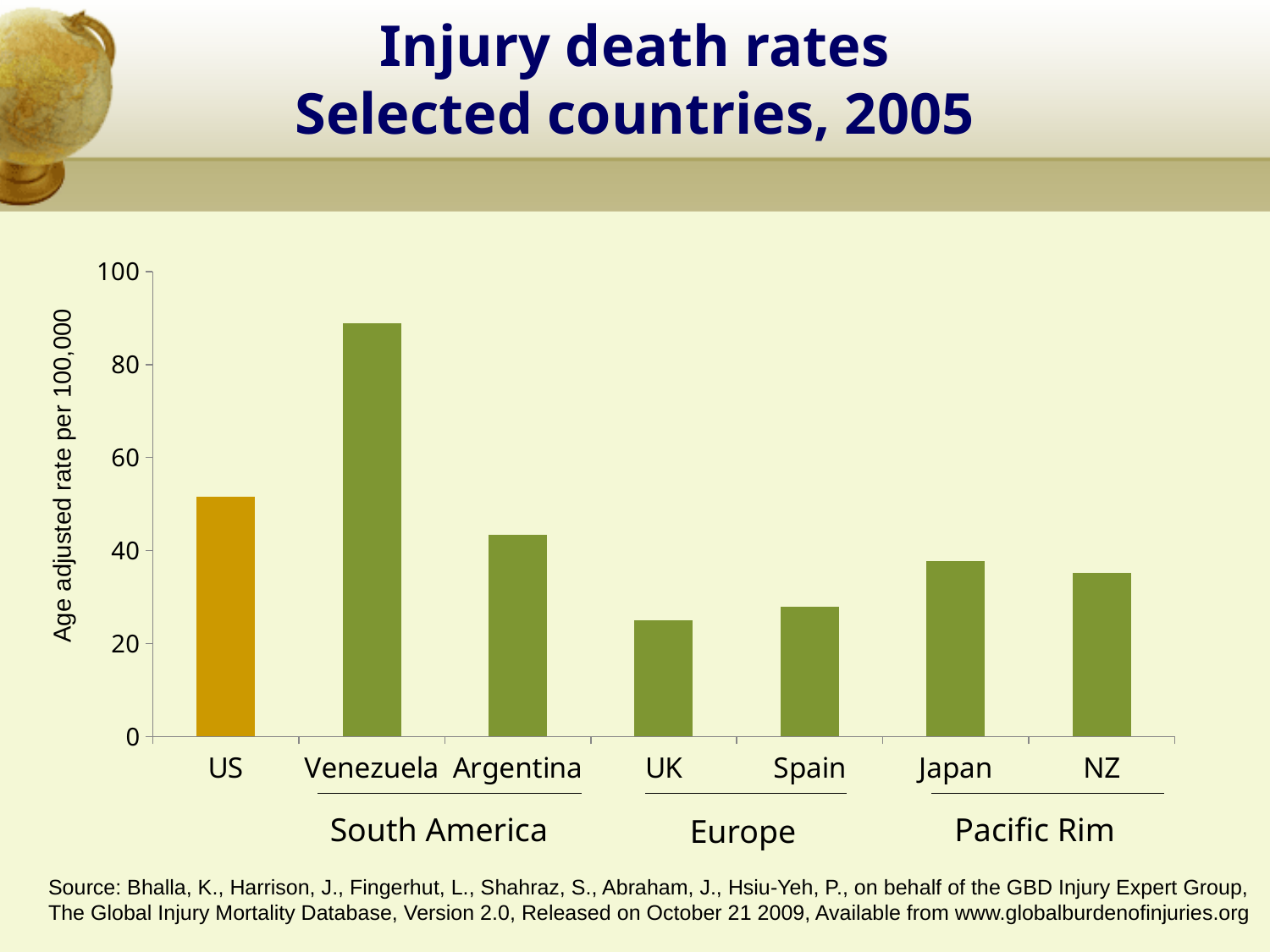
Which country has the lowest injury death rate in the chart? UK Is the value for Spain greater or less than 20? greater Which country's bar is shown in a different colour from the others? US What kind of chart is shown on the slide? bar chart How many countries are shown in the chart? 7 Is the value for the UK greater or less than 40? less Which has a higher injury death rate, the US or Argentina? US Which has a higher injury death rate, Spain or the UK? Spain Is the value for Venezuela greater or less than 80? greater Which country has the highest injury death rate in the chart? Venezuela